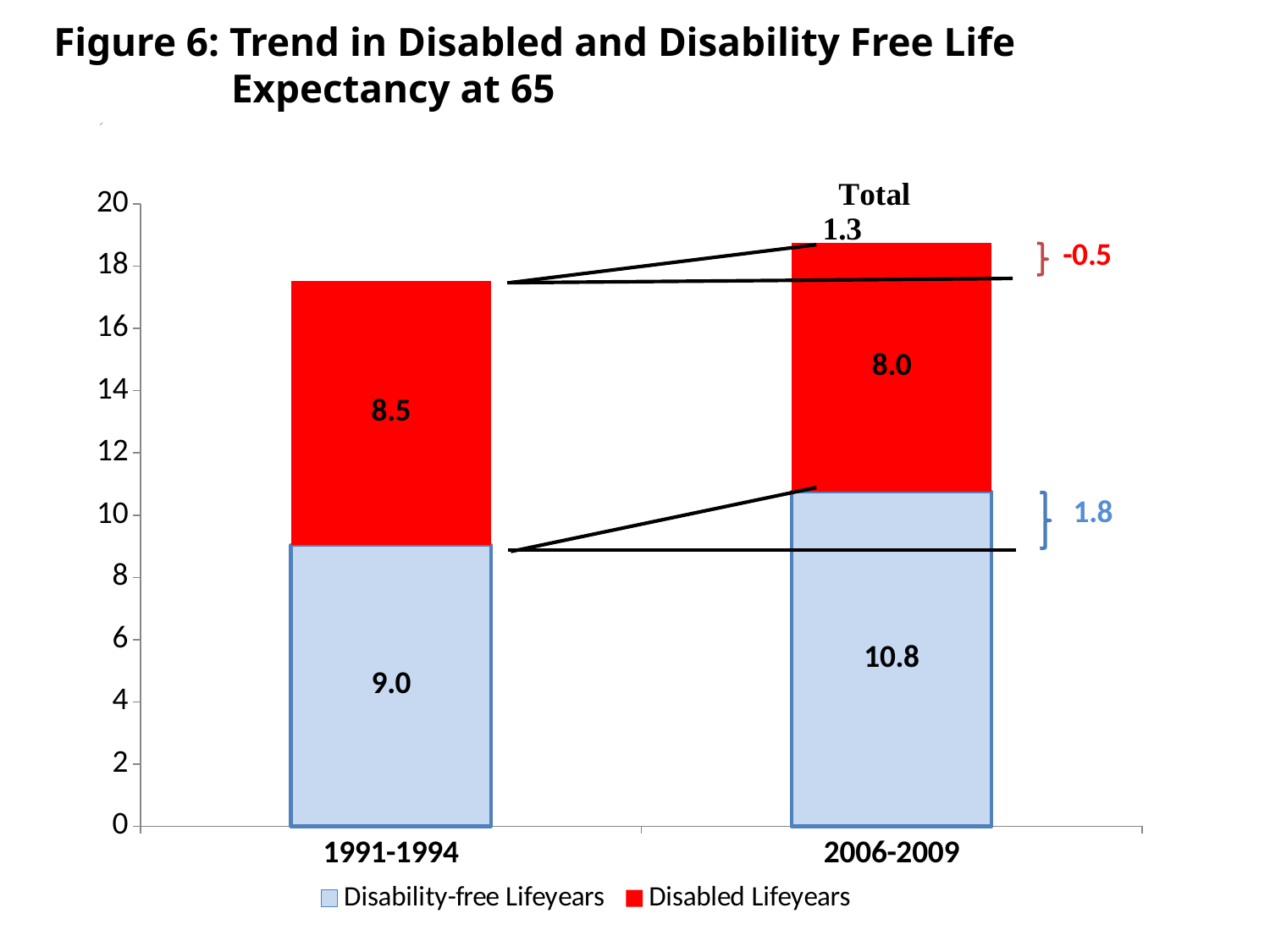
What is the value of Disabled Lifeyears for 2006-2009? 8.0 What kind of chart is shown on the slide? Stacked bar chart What is the value of Disability-free Lifeyears for 2006-2009? 10.8 How many categories are shown on the x axis? 2 What is the difference in Disability-free Lifeyears between 2006-2009 and 1991-1994? 1.8 What is the total of the stacked bar for 2006-2009? 18.8 What is the value of Disability-free Lifeyears for 1991-1994? 9.0 How many series does the legend list? 2 What is the value of Disabled Lifeyears for 1991-1994? 8.5 Which period has the larger value for Disabled Lifeyears, 1991-1994 or 2006-2009? 1991-1994 Which series is shown in red in the legend? Disabled Lifeyears What is the total of the stacked bar for 1991-1994? 17.5